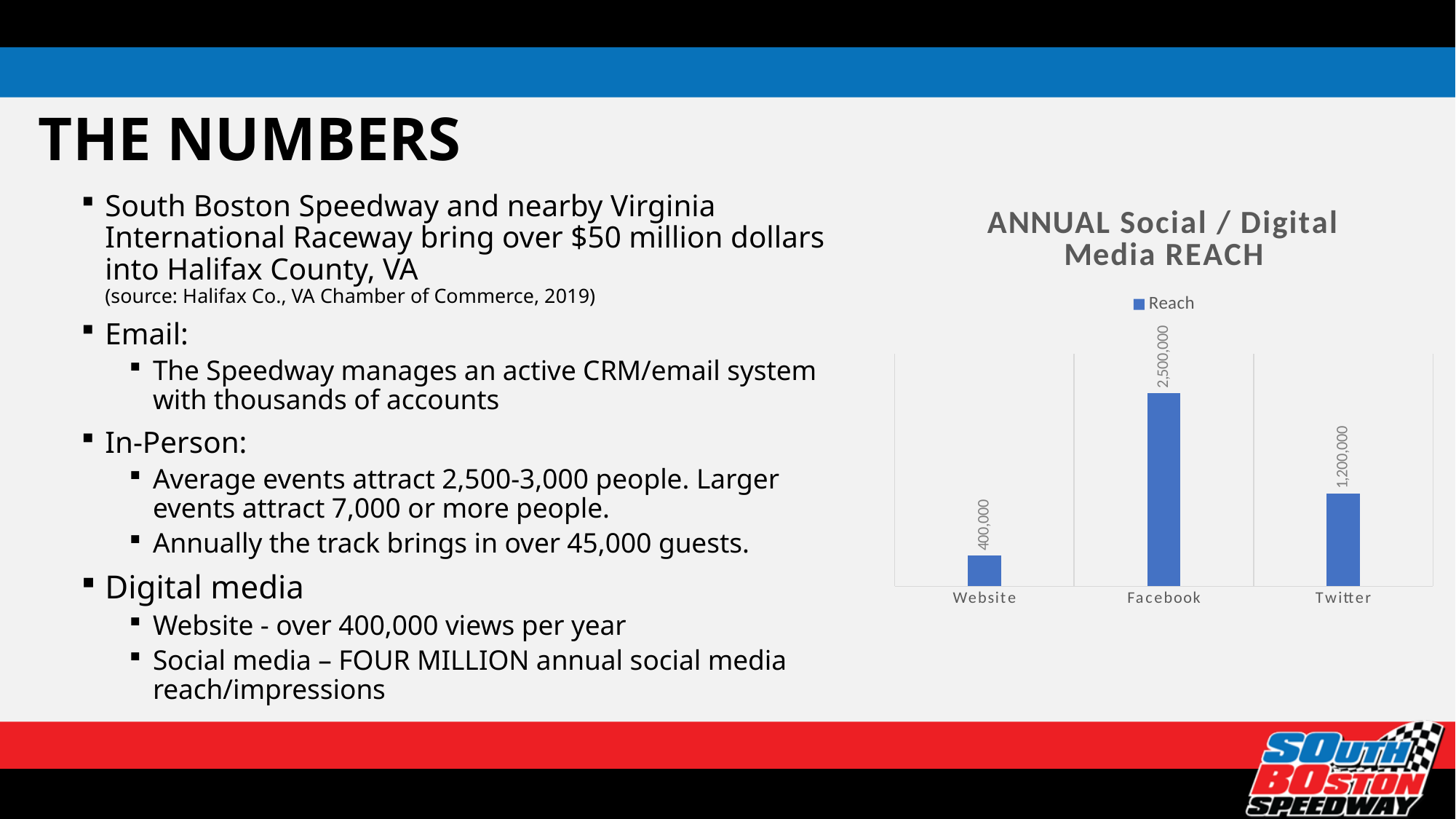
Which category has the highest Reach? Facebook What is the Reach value for Facebook? 2,500,000 Which category has the lowest Reach? Website What is the Reach value for Website? 400,000 What kind of chart is shown on the slide? Bar chart What is the difference in Reach between Twitter and Website? 800,000 How many categories are shown on the x axis of the chart? 3 What is the difference in Reach between Facebook and Twitter? 1,300,000 How many series does the chart legend list? 1 Which has a larger Reach, Twitter or Website? Twitter What is the title of the chart? ANNUAL Social / Digital Media REACH What is the Reach value for Twitter? 1,200,000